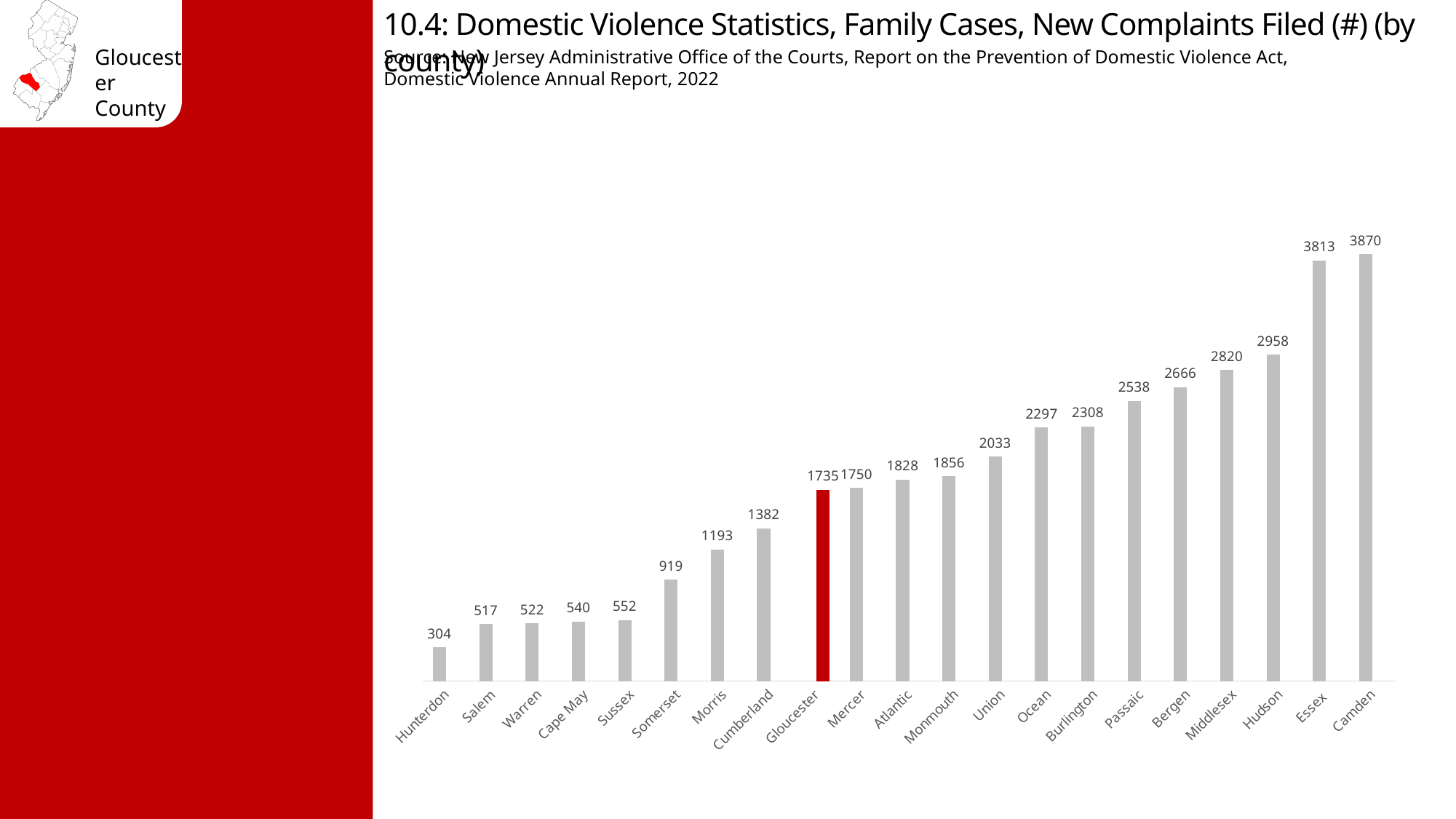
Which county has the highest value? Camden What is the value for Essex? 3813 What is the difference between the values for Hudson and Middlesex? 138 Which is larger, the value for Union or the value for Cumberland? Union How many counties are shown on the chart? 21 What is the value for Hunterdon? 304 Do the values rise or fall from left to right along the x axis? Rise Which county has the lowest value? Hunterdon What is the value for Gloucester? 1735 What is the value for Somerset? 919 What kind of chart is shown on the slide? Bar chart What is the difference between the values for Camden and Gloucester? 2135